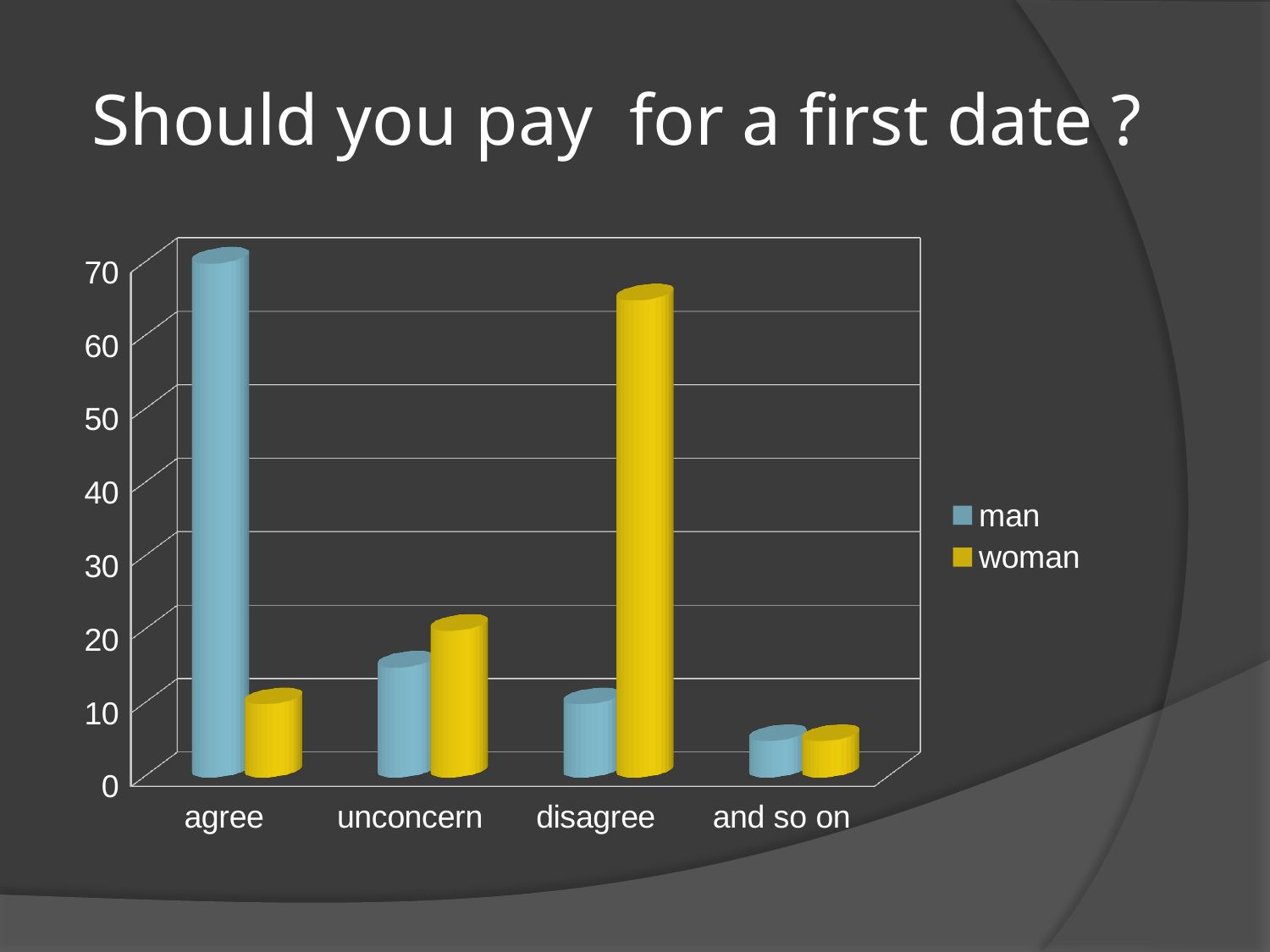
For the man series, which category has the lowest value? and so on How many categories are shown on the x axis? 4 Is the value for woman in the disagree category greater or less than 50? greater Is the value for man in the unconcern category greater or less than 30? less What kind of chart is shown on the slide? bar chart For the woman series, which category has the highest value? disagree Is the value for woman in the agree category greater or less than 20? less In the disagree category, which series has the larger value, man or woman? woman For the man series, which category has the highest value? agree What is the title of the chart? Should you pay for a first date ? How many series does the legend list? 2